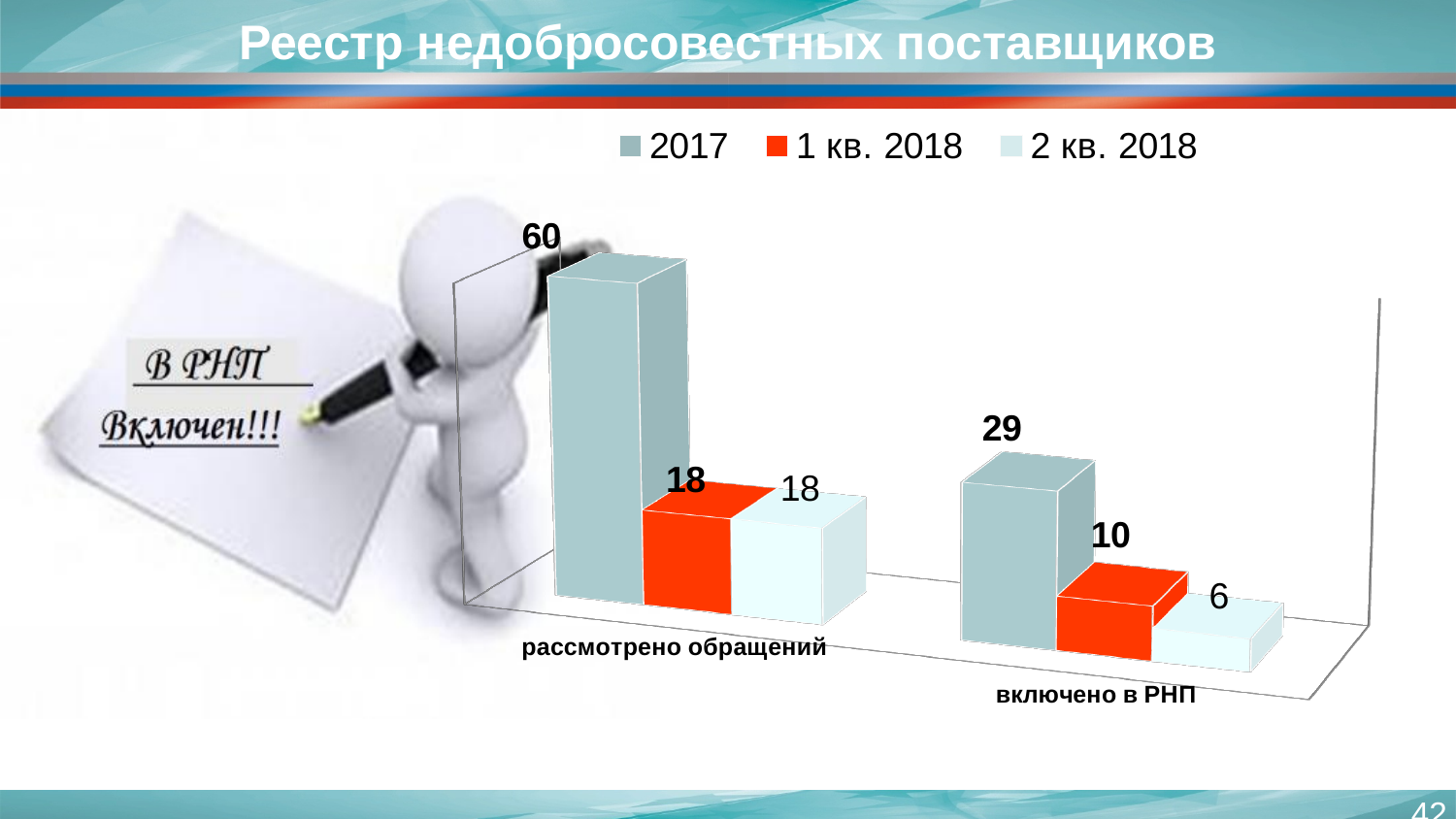
What is the value for 2 кв. 2018 in the "рассмотрено обращений" category? 18 Which series has the lowest value in the "включено в РНП" category? 2 кв. 2018 What is the difference between the 1 кв. 2018 and 2 кв. 2018 values in the "включено в РНП" category? 4 What is the value for 1 кв. 2018 in the "включено в РНП" category? 10 What is the value for 2017 in the "рассмотрено обращений" category? 60 What is the value for 2 кв. 2018 in the "включено в РНП" category? 6 Which series has the highest value in the "включено в РНП" category? 2017 How many series does the legend list? 3 What is the difference between the 2017 values for "рассмотрено обращений" and "включено в РНП"? 31 How many categories are shown on the x axis of the chart? 2 Which is larger: the 2017 value for "включено в РНП" or the 1 кв. 2018 value for "рассмотрено обращений"? 2017 value for "включено в РНП" What kind of chart is shown on the slide? Bar chart